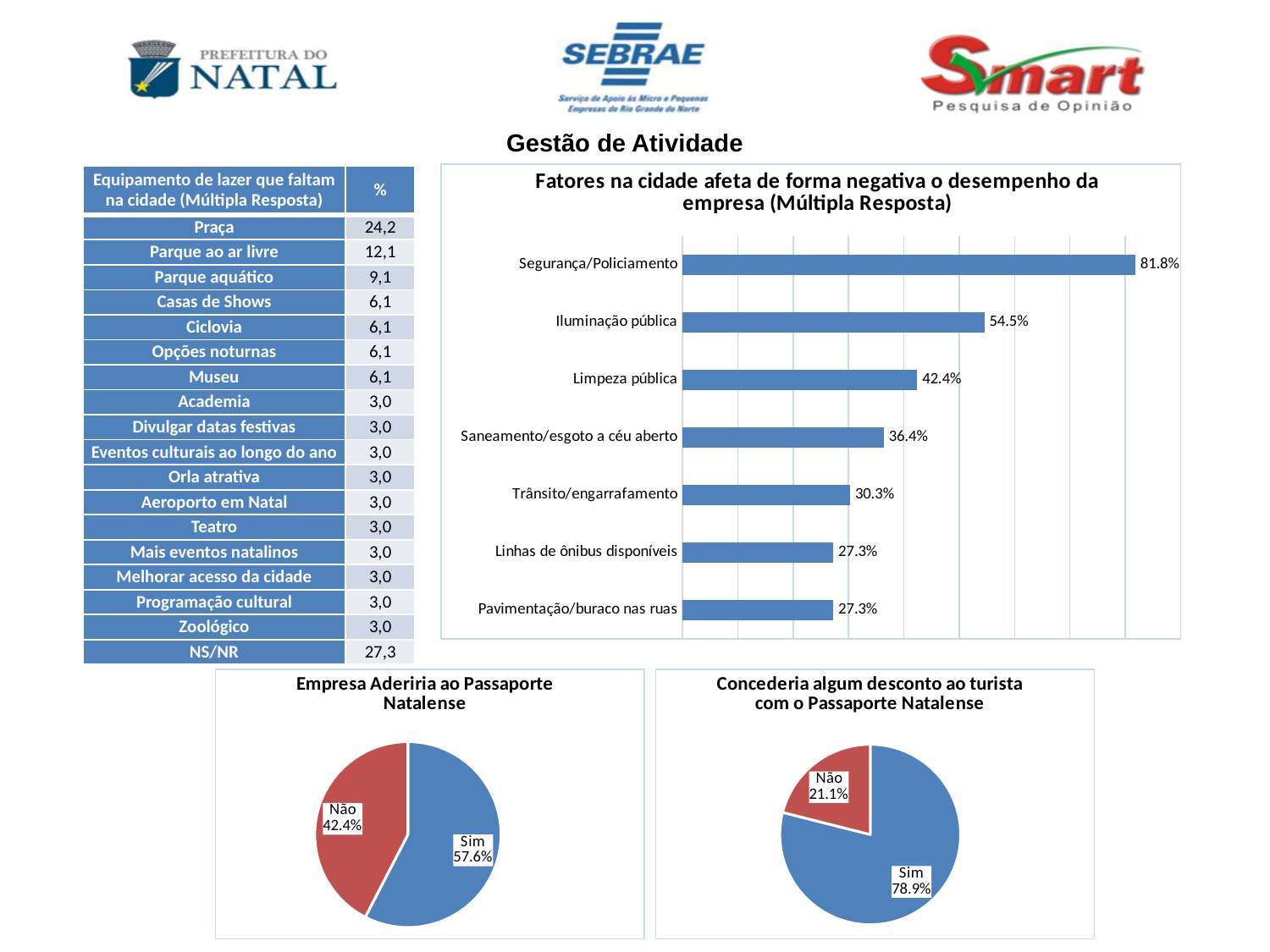
What type of chart is 'Concederia algum desconto ao turista com o Passaporte Natalense'? Pie chart In the chart 'Fatores na cidade afeta de forma negativa o desempenho da empresa', what is the value for Segurança/Policiamento? 81.8% In the chart 'Fatores na cidade afeta de forma negativa o desempenho da empresa', what is the value for Limpeza pública? 42.4% How many categories are shown in the chart 'Fatores na cidade afeta de forma negativa o desempenho da empresa'? 7 In the chart 'Concederia algum desconto ao turista com o Passaporte Natalense', what is the difference between 'Sim' and 'Não'? 57.8% In the chart 'Fatores na cidade afeta de forma negativa o desempenho da empresa', what is the difference between Iluminação pública and Trânsito/engarrafamento? 24.2% In the chart 'Fatores na cidade afeta de forma negativa o desempenho da empresa', which is larger: Saneamento/esgoto a céu aberto or Linhas de ônibus disponíveis? Saneamento/esgoto a céu aberto In the chart 'Empresa Aderiria ao Passaporte Natalense', what share of the pie is 'Sim'? 57.6% What type of chart is 'Fatores na cidade afeta de forma negativa o desempenho da empresa'? Bar chart In the chart 'Fatores na cidade afeta de forma negativa o desempenho da empresa', which category has the highest value? Segurança/Policiamento In the chart 'Concederia algum desconto ao turista com o Passaporte Natalense', what share of the pie is 'Não'? 21.1% In the chart 'Empresa Aderiria ao Passaporte Natalense', what is the value for 'Não'? 42.4%